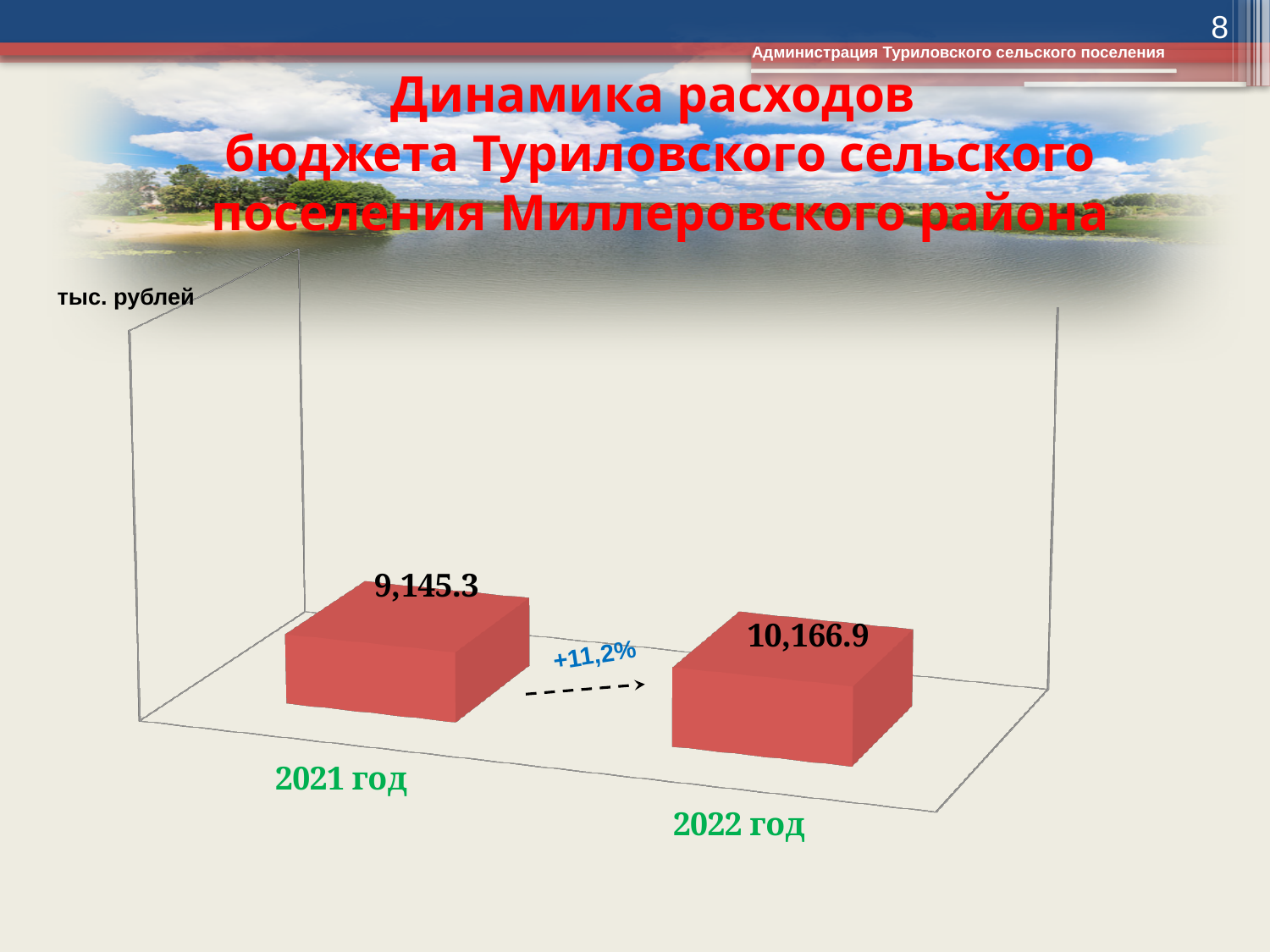
Which year has the lower value? 2021 год What unit is indicated for the chart values? тыс. рублей Which year has the higher value? 2022 год What is the value for 2022 год? 10,166.9 Is the value for 2022 год larger or smaller than the value for 2021 год? larger What is the difference between the values for 2022 год and 2021 год? 1,021.6 Do the values rise or fall from 2021 год to 2022 год? rise How many categories are shown in the chart? 2 What is the value for 2021 год? 9,145.3 What kind of chart is shown on the slide? bar chart What percentage change is shown between the two bars? +11,2%